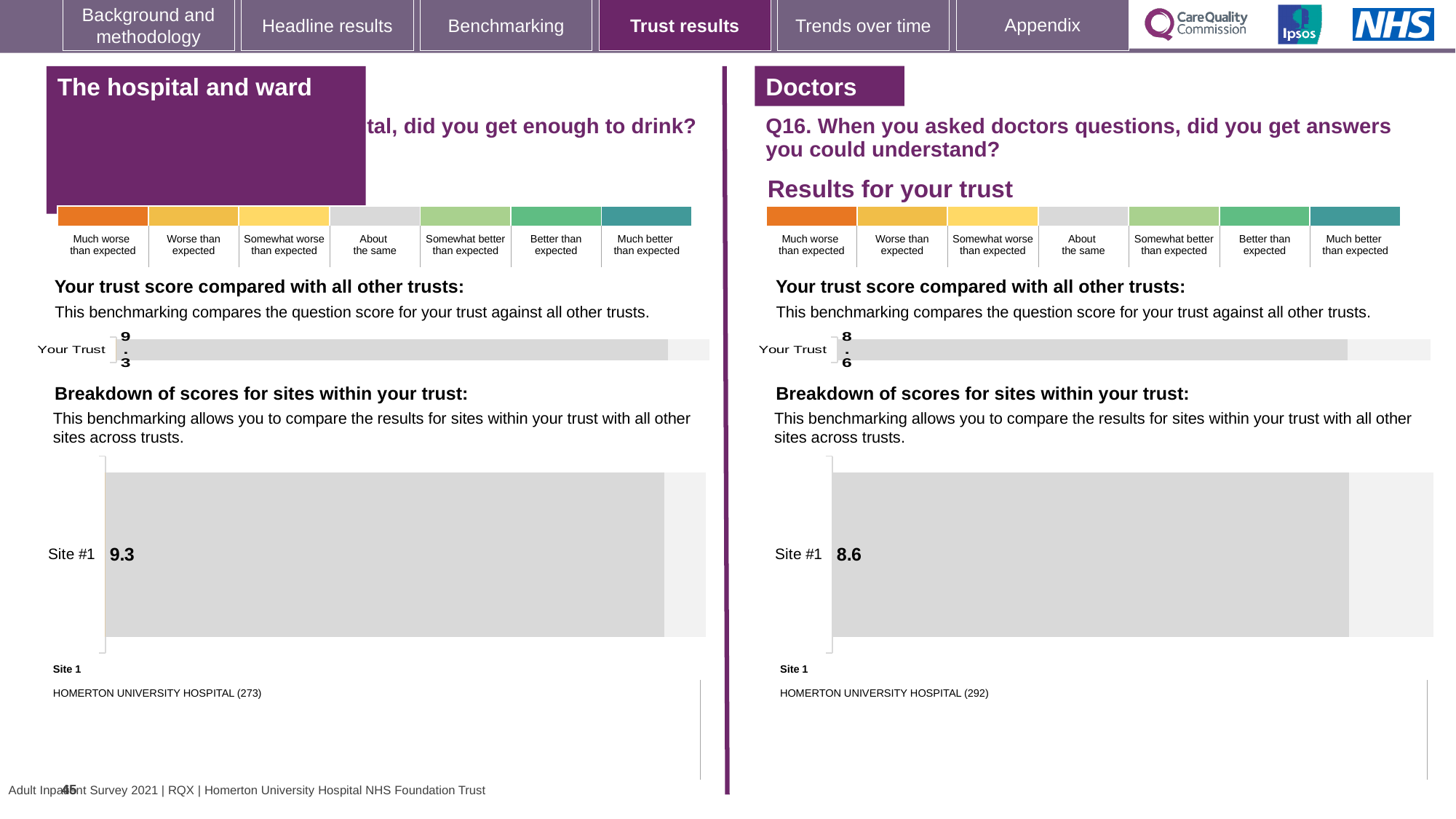
In the left panel (The hospital and ward), what is the score shown for Your Trust in the 'Your trust score compared with all other trusts' chart? 9.3 In the Doctors panel (Q16), what is the score shown for Your Trust in the 'Your trust score compared with all other trusts' chart? 8.6 What type of chart is used to show the Your Trust score in the Doctors panel? Bar chart What type of chart is used for the 'Breakdown of scores for sites within your trust' in the left panel? Bar chart In the left panel (The hospital and ward), what score is shown for Site #1 in the 'Breakdown of scores for sites within your trust' chart? 9.3 Which is larger: the Site #1 score in the left panel (The hospital and ward) or the Site #1 score in the Doctors panel (Q16)? The hospital and ward (9.3) How many sites are shown in the 'Breakdown of scores for sites within your trust' chart in the left panel (The hospital and ward)? 1 In the left panel (The hospital and ward), which site name is listed as Site 1 below the breakdown chart? HOMERTON UNIVERSITY HOSPITAL (273) What is the difference between the Your Trust score in the left panel (9.3) and the Your Trust score in the Doctors panel (8.6)? 0.7 How many sites are shown in the 'Breakdown of scores for sites within your trust' chart in the Doctors panel? 1 In the Doctors panel (Q16), what score is shown for Site #1 in the 'Breakdown of scores for sites within your trust' chart? 8.6 In the Doctors panel, which site name is listed as Site 1 below the breakdown chart? HOMERTON UNIVERSITY HOSPITAL (292)